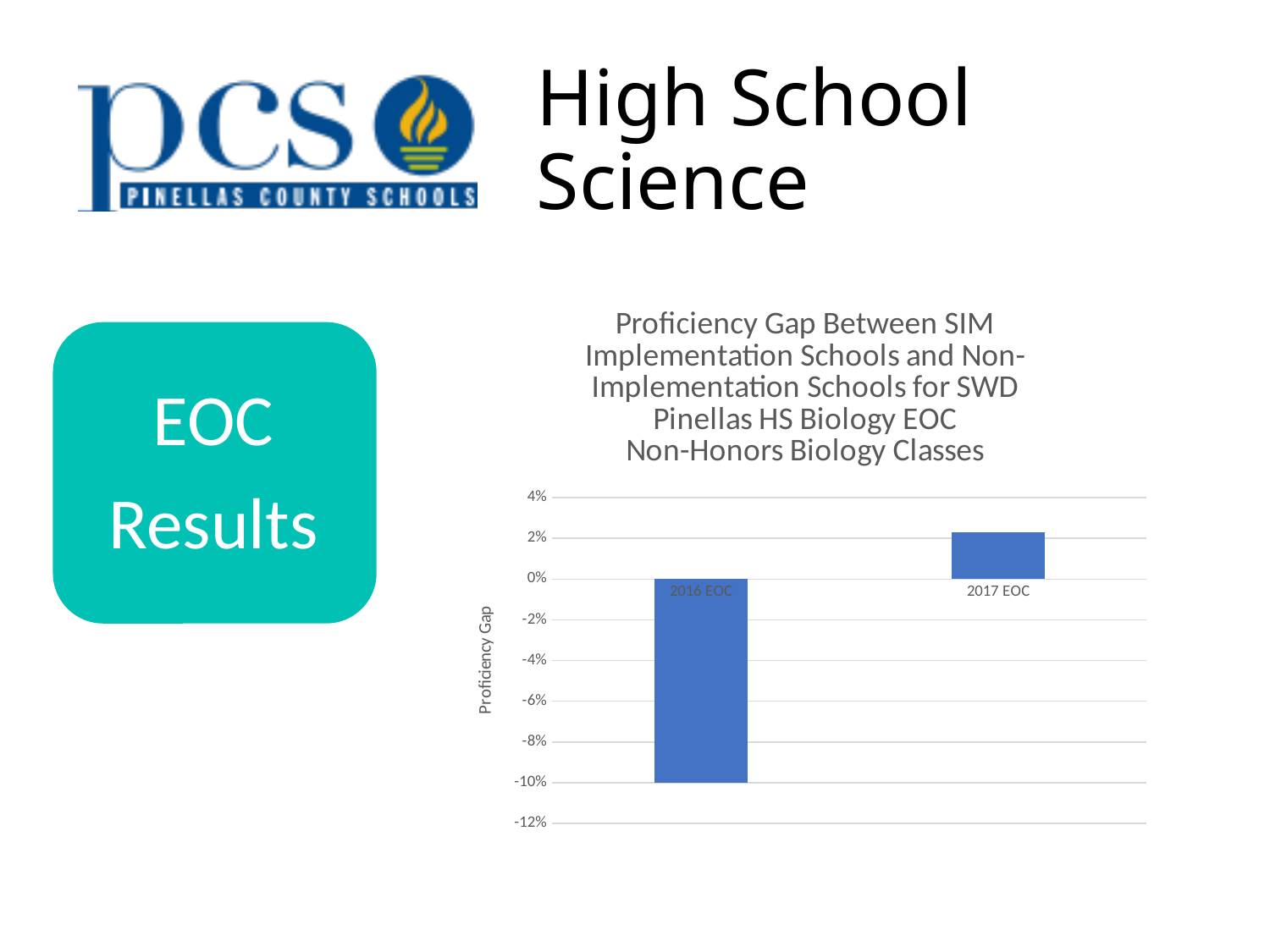
Which category has the higher proficiency gap value, 2016 EOC or 2017 EOC? 2017 EOC Is the value for 2017 EOC greater or less than 4%? less Do the values rise or fall from 2016 EOC to 2017 EOC? rise Which category has the lowest value in the chart? 2016 EOC Which category has the highest value in the chart? 2017 EOC What is the proficiency gap value for 2016 EOC? -10% Is the value for 2016 EOC greater or less than -8%? less Is the value for 2017 EOC greater or less than 0%? greater What is the lowest value shown on the vertical axis of the chart? -12% What kind of chart is shown on the slide? bar chart What is the label on the vertical axis of the chart? Proficiency Gap How many categories are plotted in the chart? 2